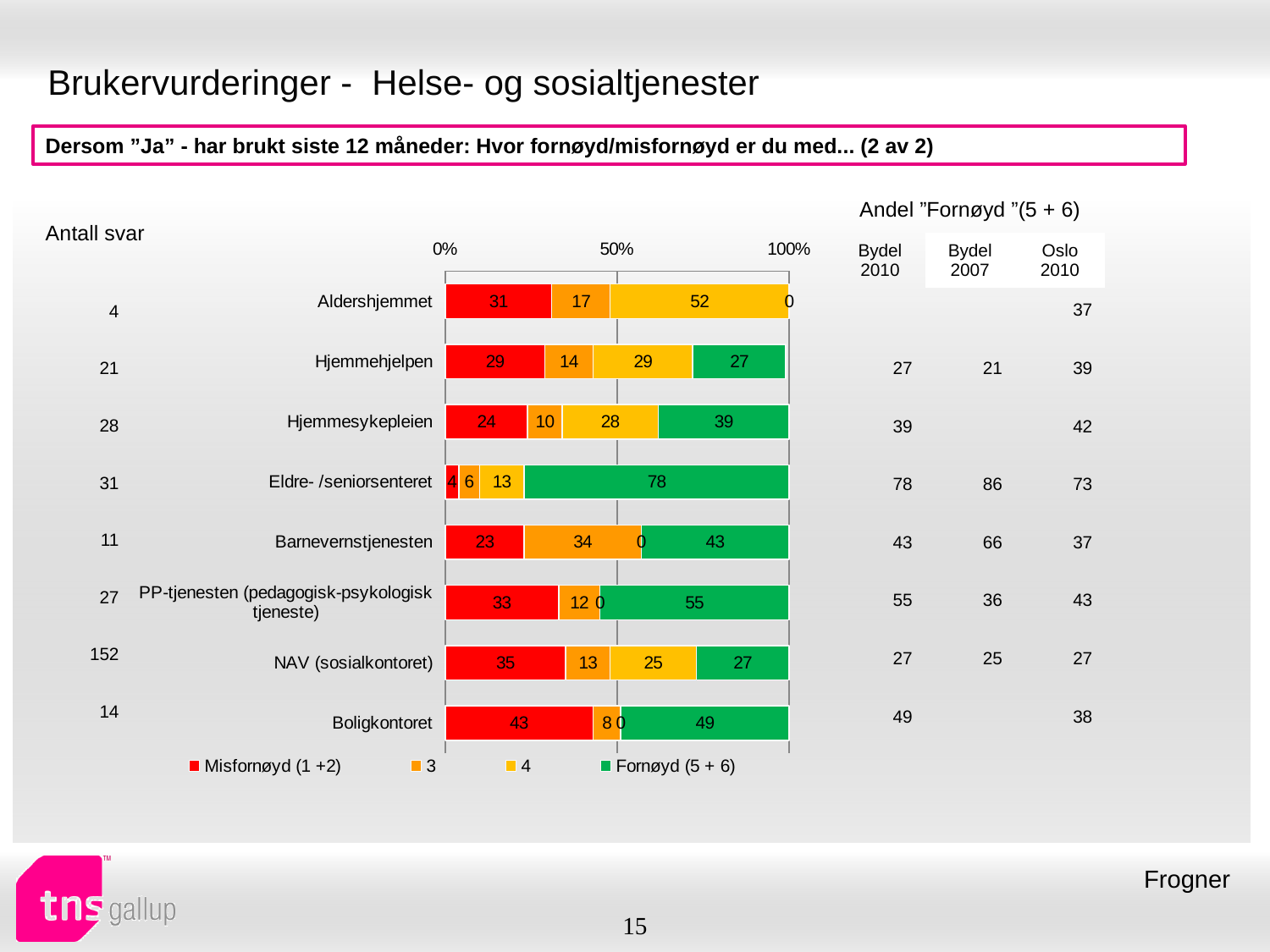
How many series does the legend list? 4 What is the value of the Misfornøyd (1 +2) series for NAV (sosialkontoret)? 35 Which category has the lowest Misfornøyd (1 +2) value? Eldre- /seniorsenteret Which category has the highest Fornøyd (5 + 6) value? Eldre- /seniorsenteret What kind of chart is shown on the slide? Stacked bar chart What is the difference between the Misfornøyd (1 +2) values for Boligkontoret and Aldershjemmet? 12 How many categories are shown in the chart? 8 What is the value of the series labelled 3 for Barnevernstjenesten? 34 What is the value of the series labelled 4 for Aldershjemmet? 52 Which category has the highest Misfornøyd (1 +2) value? Boligkontoret What is the value of the Fornøyd (5 + 6) series for Eldre- /seniorsenteret? 78 Which has a larger Fornøyd (5 + 6) value, Hjemmesykepleien or Hjemmehjelpen? Hjemmesykepleien